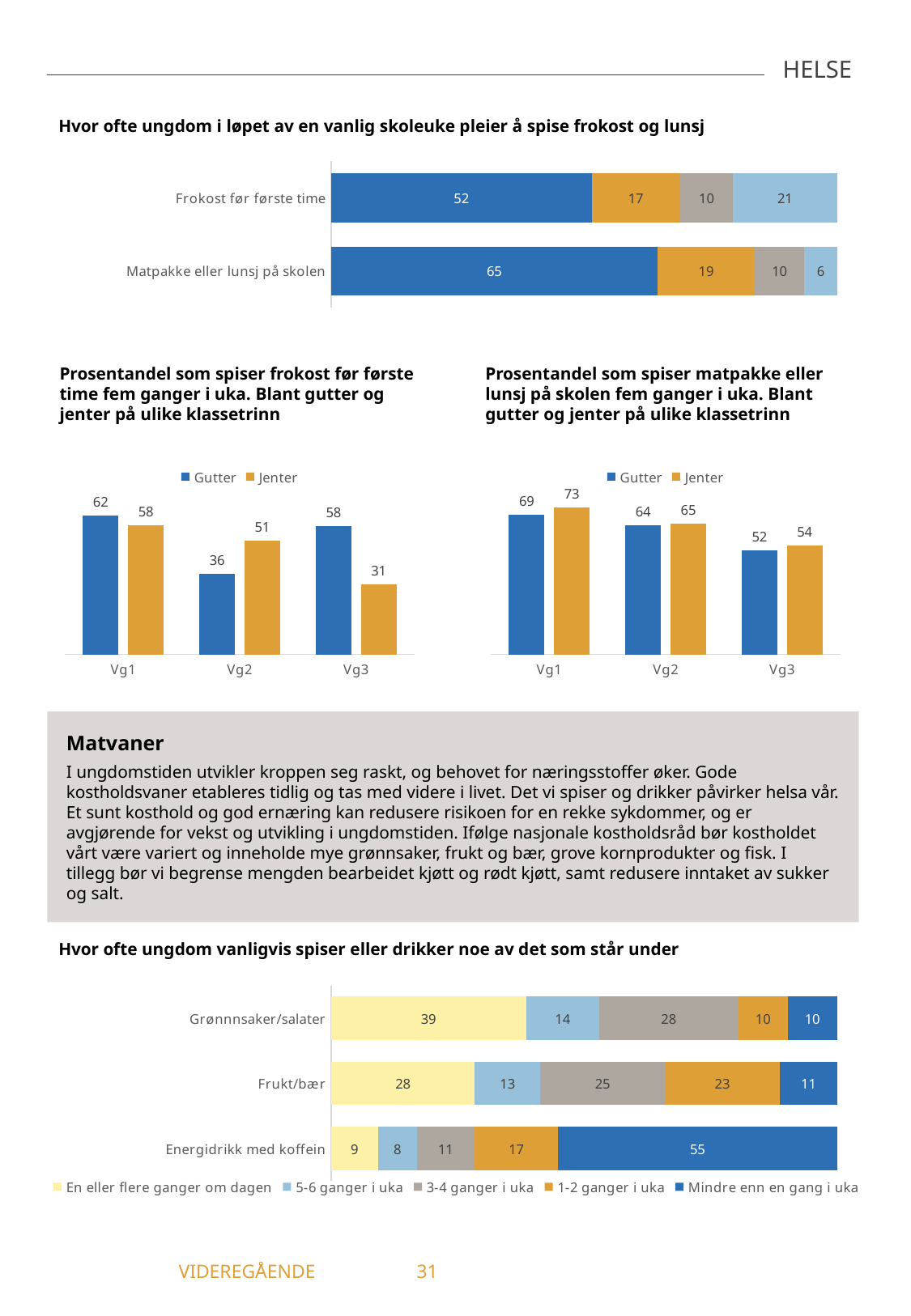
In the chart 'Prosentandel som spiser matpakke eller lunsj på skolen fem ganger i uka', what is the value for Jenter at Vg1? 73 In the chart 'Prosentandel som spiser frokost før første time fem ganger i uka', what is the value for Jenter at Vg2? 51 In the chart 'Hvor ofte ungdom vanligvis spiser eller drikker noe av det som står under', which is larger for 'En eller flere ganger om dagen': Grønnnsaker/salater or Frukt/bær? Grønnnsaker/salater In the chart 'Prosentandel som spiser matpakke eller lunsj på skolen fem ganger i uka', how many series does the legend list? 2 In the chart 'Prosentandel som spiser frokost før første time fem ganger i uka', which group has the lowest value at Vg3? Jenter In the chart 'Hvor ofte ungdom vanligvis spiser eller drikker noe av det som står under', how many series does the legend list? 5 In the chart 'Prosentandel som spiser frokost før første time fem ganger i uka', what is the difference between Gutter and Jenter at Vg3? 27 In the chart 'Hvor ofte ungdom vanligvis spiser eller drikker noe av det som står under', what is the value for 'Mindre enn en gang i uka' for 'Energidrikk med koffein'? 55 In the chart 'Hvor ofte ungdom i løpet av en vanlig skoleuke pleier å spise frokost og lunsj', what is the value of the first (dark blue) segment for 'Matpakke eller lunsj på skolen'? 65 In the chart 'Prosentandel som spiser matpakke eller lunsj på skolen fem ganger i uka', how do the Gutter values change from Vg1 to Vg3? They fall In the chart 'Hvor ofte ungdom i løpet av en vanlig skoleuke pleier å spise frokost og lunsj', what is the total of the stacked bar for 'Frokost før første time'? 100 What kind of chart is 'Hvor ofte ungdom vanligvis spiser eller drikker noe av det som står under'? Stacked bar chart